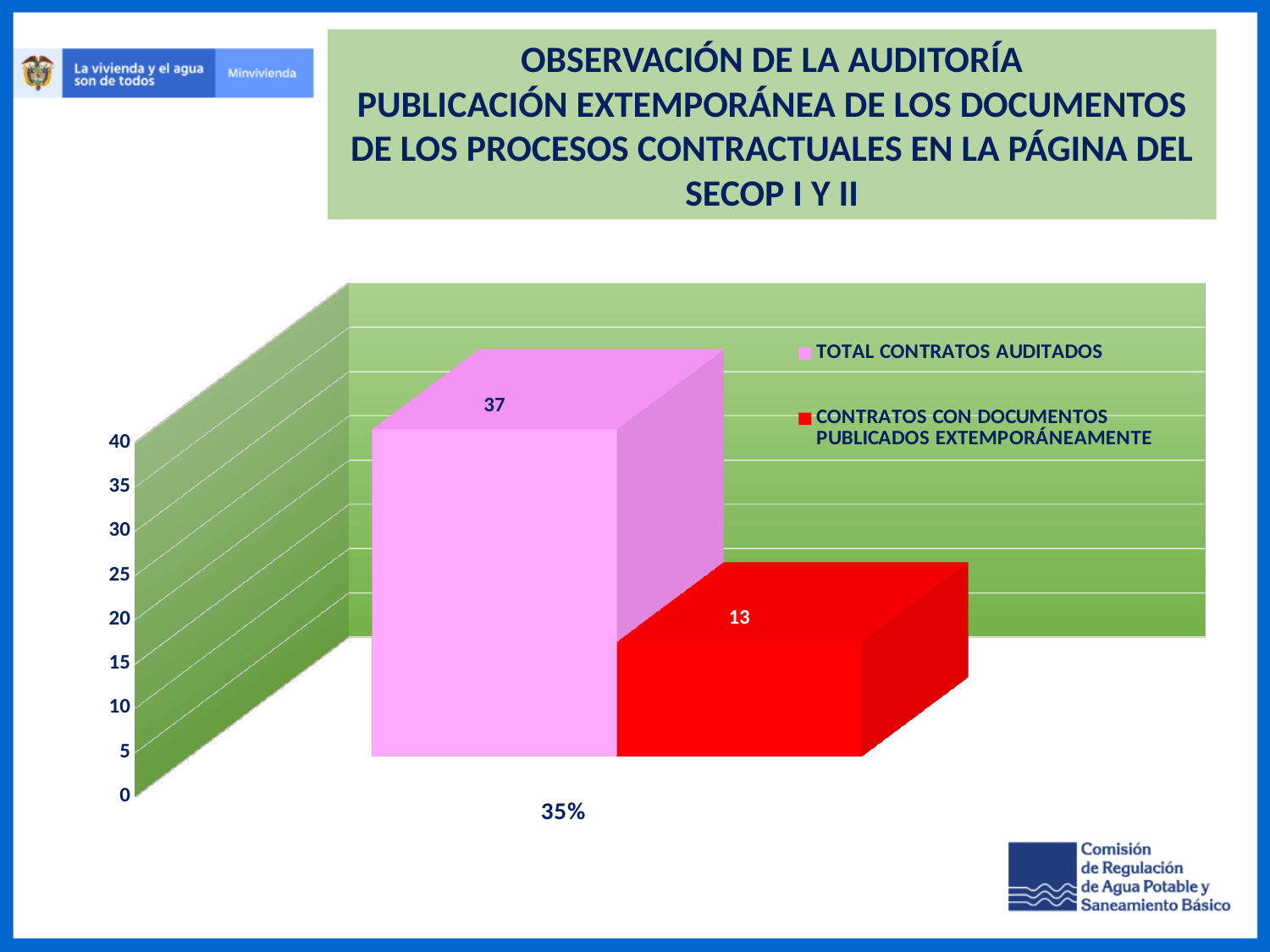
What colour is the bar for TOTAL CONTRATOS AUDITADOS? pink What is the value for TOTAL CONTRATOS AUDITADOS? 37 What percentage label is shown below the chart? 35% Which series has the highest value? TOTAL CONTRATOS AUDITADOS What kind of chart is shown on the slide? bar chart What is the value for CONTRATOS CON DOCUMENTOS PUBLICADOS EXTEMPORÁNEAMENTE? 13 Is the value for TOTAL CONTRATOS AUDITADOS greater or less than 30? greater Which series has the lowest value? CONTRATOS CON DOCUMENTOS PUBLICADOS EXTEMPORÁNEAMENTE How many series does the legend list? 2 What is the difference between TOTAL CONTRATOS AUDITADOS and CONTRATOS CON DOCUMENTOS PUBLICADOS EXTEMPORÁNEAMENTE? 24 Which is larger, TOTAL CONTRATOS AUDITADOS or CONTRATOS CON DOCUMENTOS PUBLICADOS EXTEMPORÁNEAMENTE? TOTAL CONTRATOS AUDITADOS Is the value for CONTRATOS CON DOCUMENTOS PUBLICADOS EXTEMPORÁNEAMENTE greater or less than 20? less